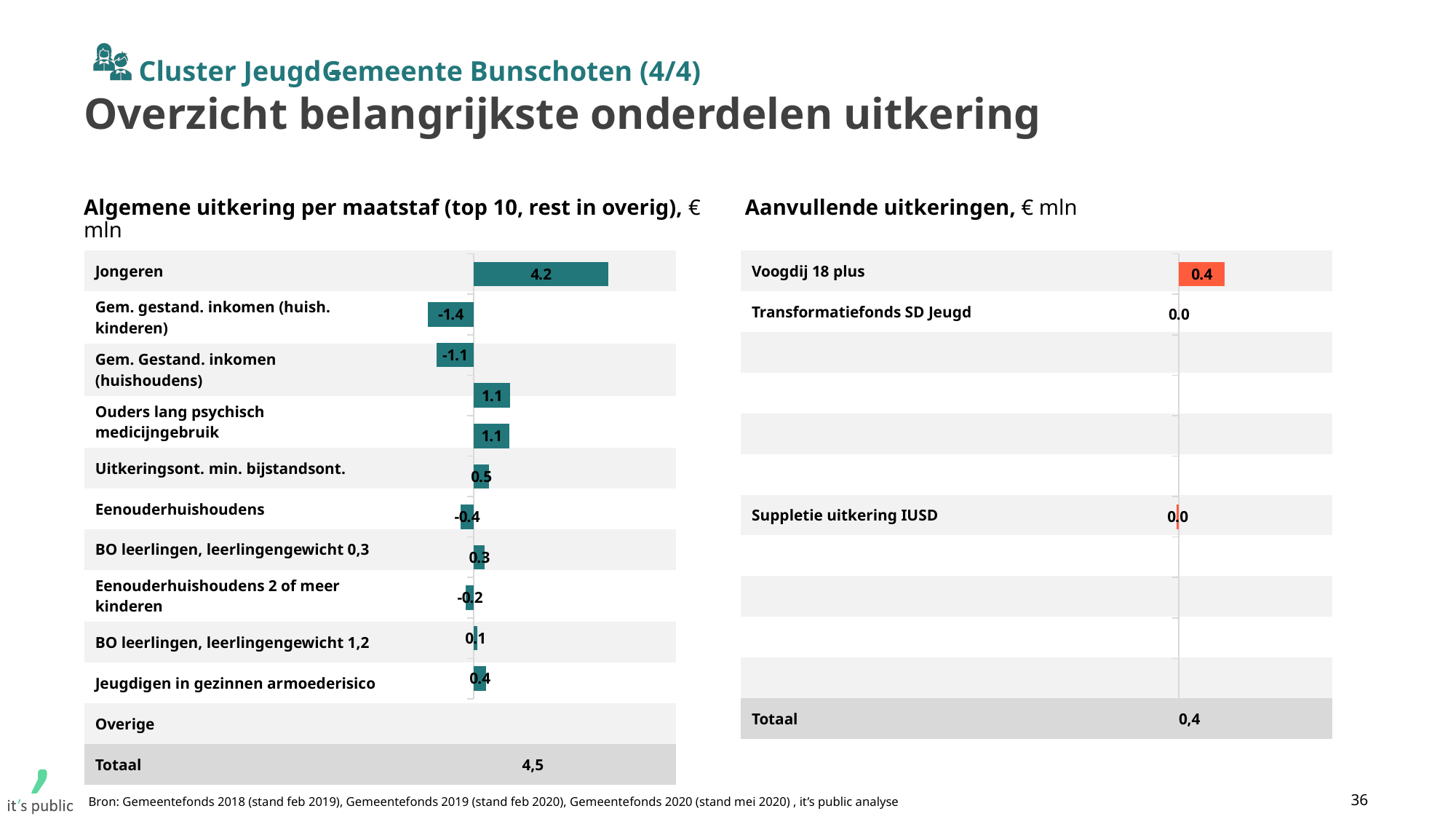
In the chart 'Aanvullende uitkeringen', what is the value for Suppletie uitkering IUSD? 0.0 What kind of chart is 'Algemene uitkering per maatstaf'? bar chart In the chart 'Aanvullende uitkeringen', what is the Totaal shown at the bottom? 0,4 In the chart 'Algemene uitkering per maatstaf', which category has the highest value? Jongeren In the chart 'Aanvullende uitkeringen', what is the value for Voogdij 18 plus? 0.4 In the chart 'Algemene uitkering per maatstaf', what is the Totaal shown at the bottom? 4,5 In the chart 'Algemene uitkering per maatstaf', which category has the lowest value? Gem. gestand. inkomen (huish. kinderen) Which is larger: Jongeren in the left chart or Voogdij 18 plus in the right chart? Jongeren In the chart 'Algemene uitkering per maatstaf', what is the value for Jongeren? 4.2 In the chart 'Aanvullende uitkeringen', which category has the highest value? Voogdij 18 plus In what unit are the values in both charts expressed? € mln In the chart 'Aanvullende uitkeringen', what is the value for Transformatiefonds SD Jeugd? 0.0